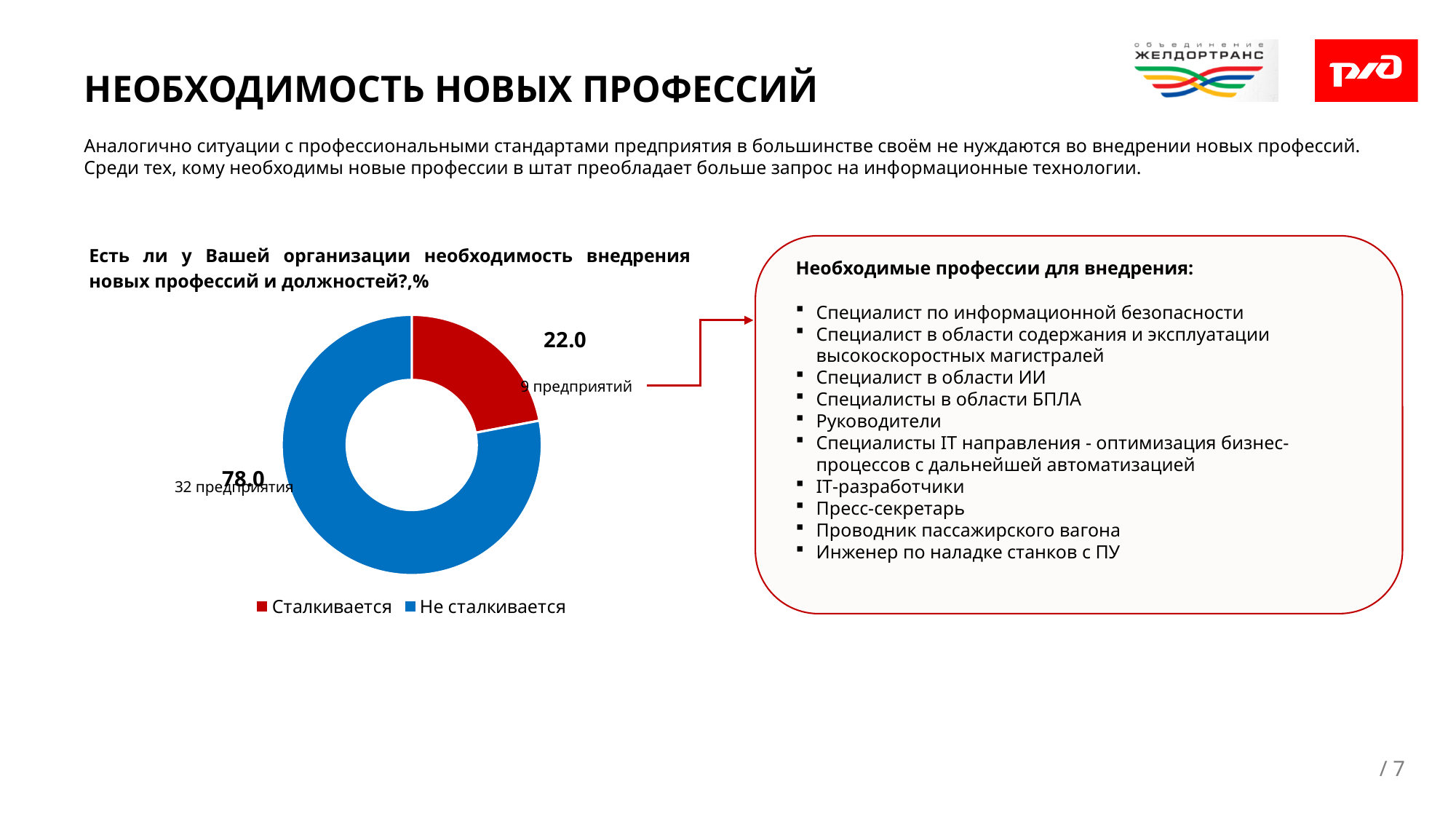
Which is larger: the value for "Сталкивается" or for "Не сталкивается"? Не сталкивается What colour is the "Сталкивается" slice in the chart? Red What is the difference between the values for "Не сталкивается" and "Сталкивается"? 56.0 Which category has the smallest share in the chart? Сталкивается How many enterprises does the "Сталкивается" slice correspond to, according to the annotation? 9 предприятий What is the value for "Не сталкивается" in the chart? 78.0 How many entries does the chart legend list? 2 How many categories does the chart show? 2 How many enterprises does the "Не сталкивается" slice correspond to, according to the annotation? 32 предприятия What type of chart is shown on the slide? Doughnut (pie) chart Which category has the largest share in the chart? Не сталкивается What is the value for "Сталкивается" in the chart? 22.0